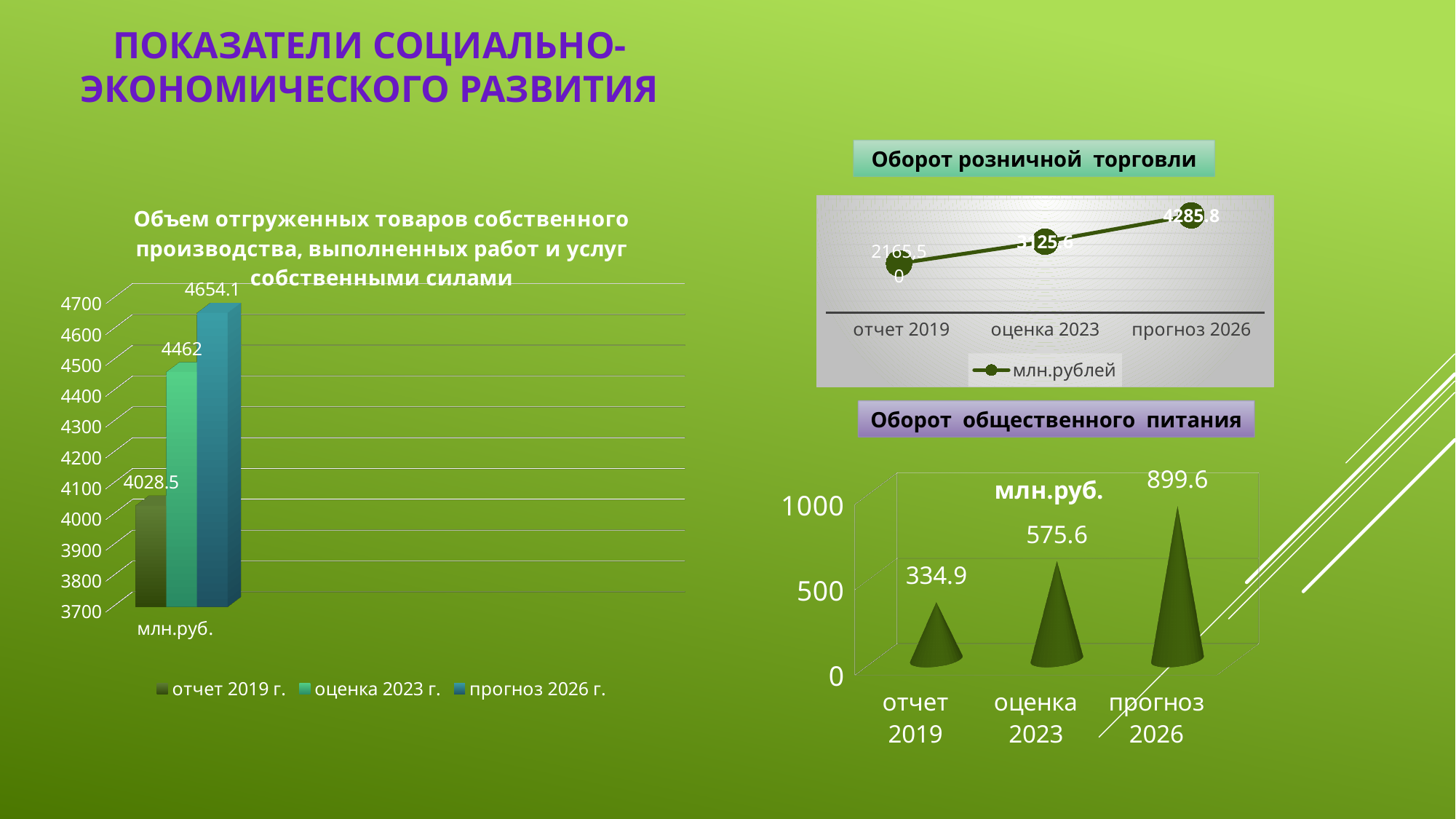
In the chart 'Оборот общественного питания', what is the value for 'оценка 2023'? 575.6 In the chart 'Объем отгруженных товаров собственного производства, выполненных работ и услуг собственными силами', what is the value for 'отчет 2019 г.'? 4028.5 In the chart 'Объем отгруженных товаров собственного производства, выполненных работ и услуг собственными силами', what is the value for 'прогноз 2026 г.'? 4654.1 What kind of chart is 'Оборот розничной торговли'? line chart In the chart 'Оборот розничной торговли', what is the value for 'прогноз 2026'? 4285.8 In the chart 'Объем отгруженных товаров собственного производства, выполненных работ и услуг собственными силами', what is the difference between 'оценка 2023 г.' and 'отчет 2019 г.'? 433.5 In the chart 'Оборот общественного питания', is the value for 'прогноз 2026' greater or less than 500? greater In the chart 'Оборот общественного питания', what is the difference between 'прогноз 2026' and 'отчет 2019'? 564.7 In the chart 'Объем отгруженных товаров собственного производства, выполненных работ и услуг собственными силами', which series has the lowest value? отчет 2019 г. How many series does the legend list in the chart 'Объем отгруженных товаров собственного производства, выполненных работ и услуг собственными силами'? 3 In the chart 'Оборот розничной торговли', do the values rise or fall from 'отчет 2019' to 'прогноз 2026'? rise In the chart 'Оборот розничной торговли', what is the value for 'отчет 2019'? 2165.5